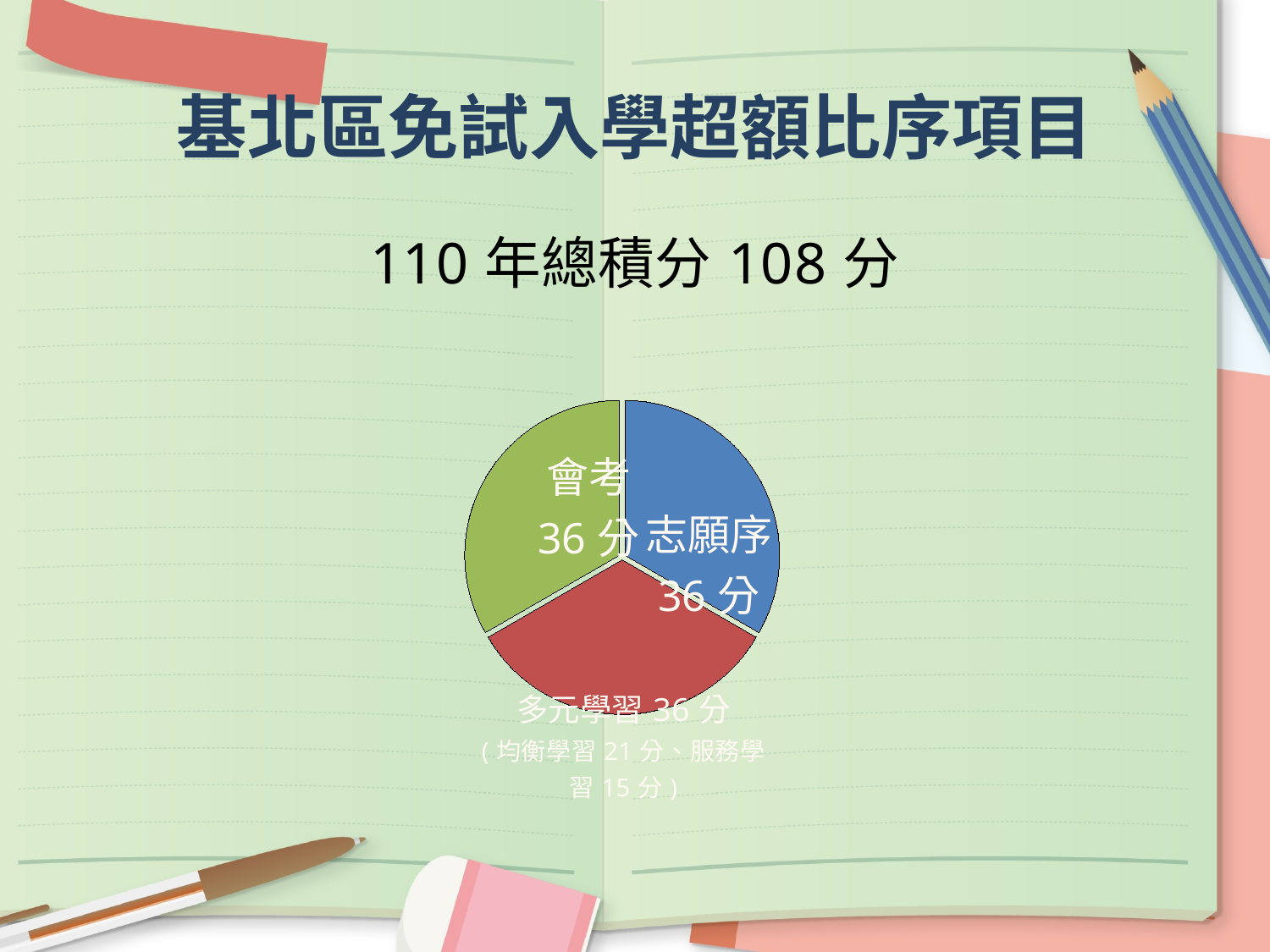
What share of the total 108 分 does the 志願序 slice represent? one third What is the value shown for 多元學習 in the pie chart? 36 分 How many slices does the pie chart have? 3 How many points of 多元學習 come from 服務學習 according to the note under the chart? 15 分 Which is larger, the 會考 slice or the 多元學習 slice? they are equal What colour is the 志願序 slice in the pie chart? blue How many points of 多元學習 come from 均衡學習 according to the note under the chart? 21 分 What is the difference between the 會考 value and the 志願序 value? 0 分 According to the slide, what is the total score (總積分) for 110 年? 108 分 What is the value shown for 會考 in the pie chart? 36 分 What is the value shown for 志願序 in the pie chart? 36 分 What kind of chart is shown on the slide? pie chart